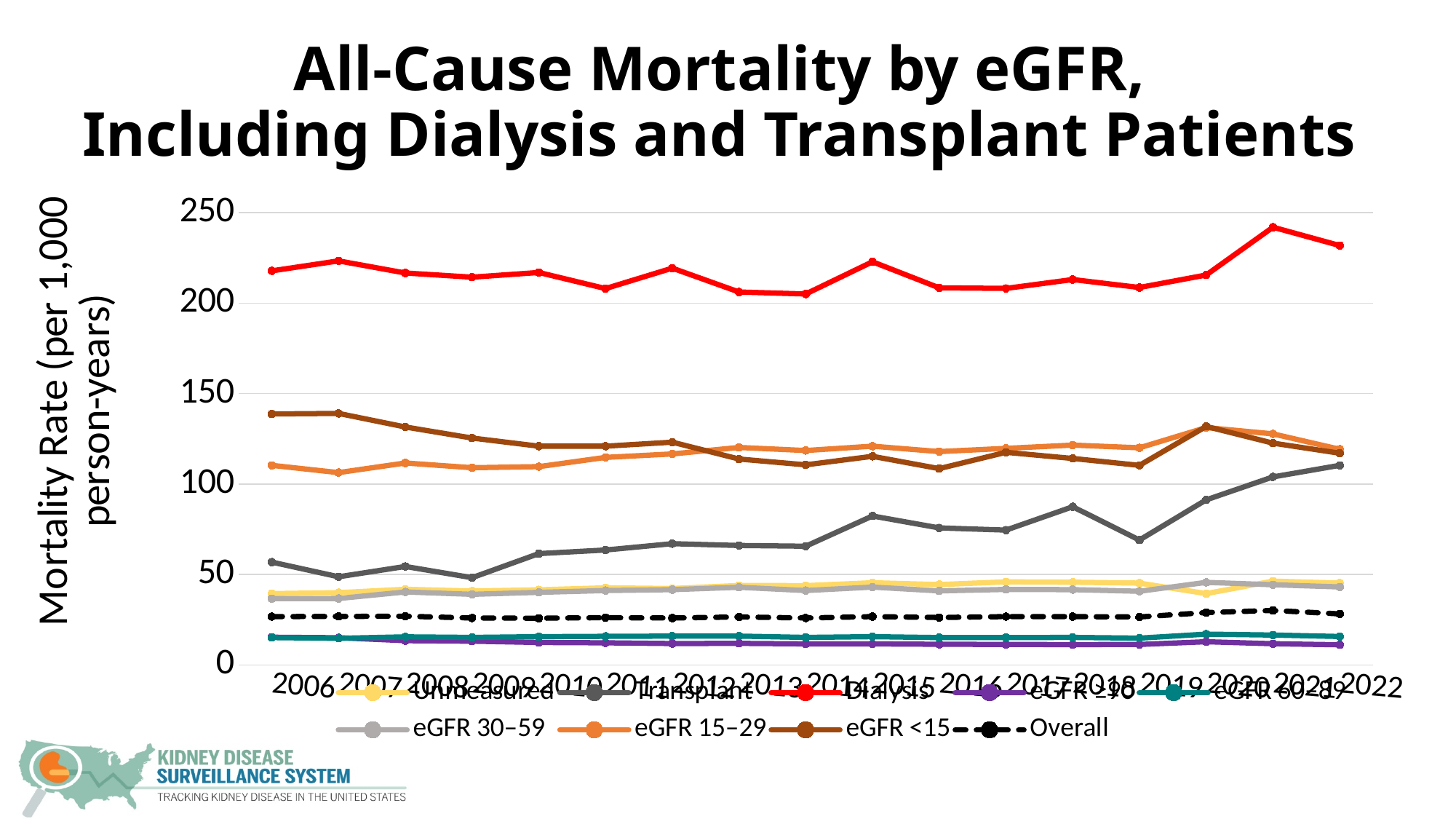
Does the Transplant series generally rise or fall from 2006 to 2022? Rise What is the label of the y axis? Mortality Rate (per 1,000 person-years) Which series has the highest mortality rate across all years? Dialysis What kind of chart is shown on the slide? Line chart In 2022, which is larger: the value for Transplant or the value for eGFR 30–59? Transplant Is the value for Transplant in 2006 greater or less than 100? less Is the value for Overall in 2022 greater or less than 50? less How many years are plotted along the x axis? 17 Is the value for eGFR <15 in 2006 greater or less than 100? greater In which year does the Dialysis series reach its highest value? 2021 How many series does the legend list? 9